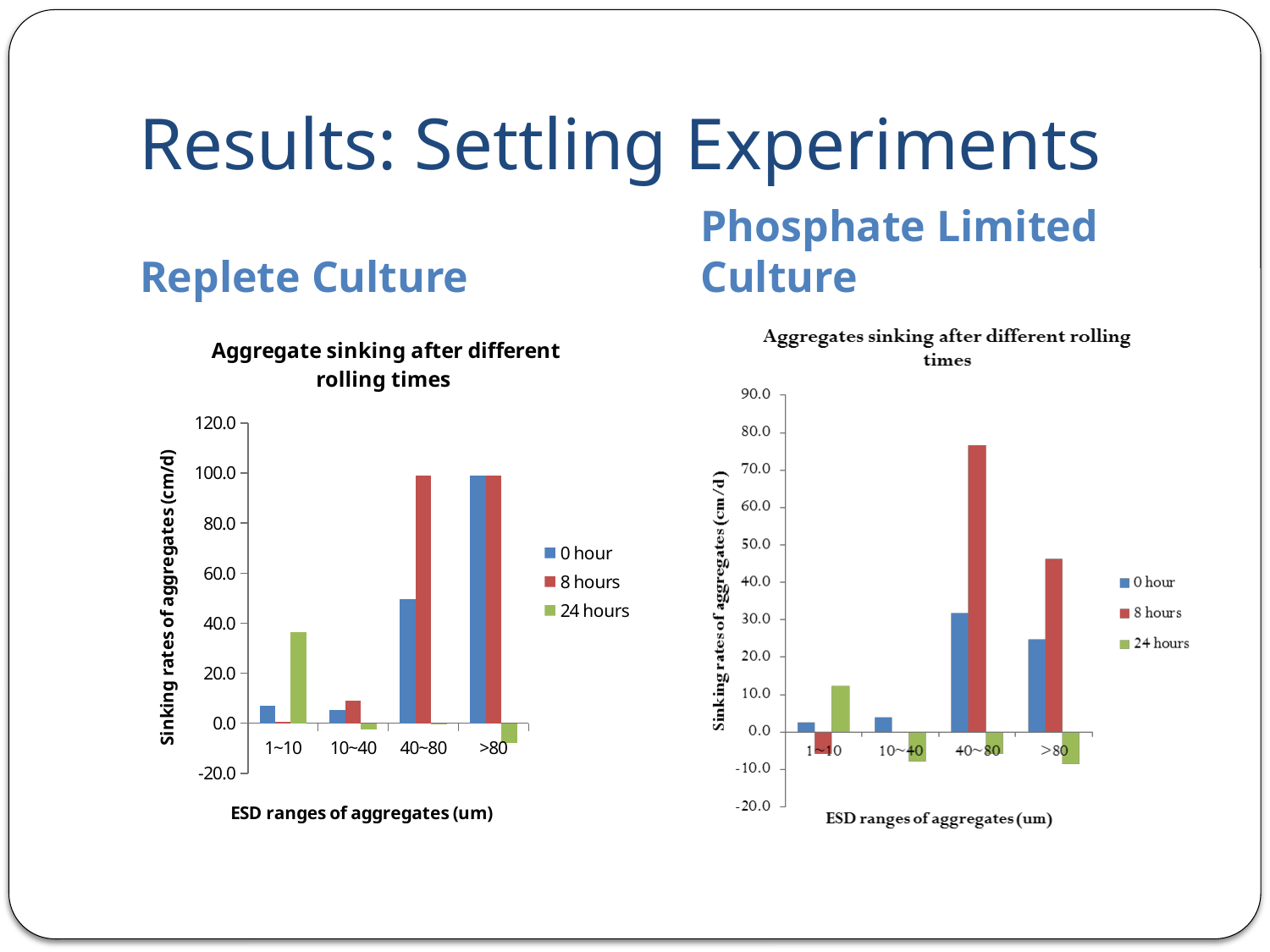
In the Replete Culture chart, is the 24 hours value for 1~10 greater or less than 20.0? greater In the Phosphate Limited Culture chart, what is the label of the y axis? Sinking rates of aggregates (cm/d) In the Replete Culture chart, how many series does the legend list? 3 In the Replete Culture chart, which is larger for 40~80: the 0 hour value or the 8 hours value? 8 hours In the Phosphate Limited Culture chart, which is larger for >80: the 0 hour value or the 8 hours value? 8 hours In the Replete Culture chart, is the 0 hour value for 40~80 greater or less than 60.0? less In the Replete Culture chart, which ESD range has the highest 0 hour value? >80 In the Phosphate Limited Culture chart, how many ESD range categories are shown on the x axis? 4 In the Phosphate Limited Culture chart, which ESD range has the highest 8 hours value? 40~80 In the Phosphate Limited Culture chart, is the 8 hours value for 40~80 greater or less than 70.0? greater In the Replete Culture chart, what kind of chart is shown? bar chart